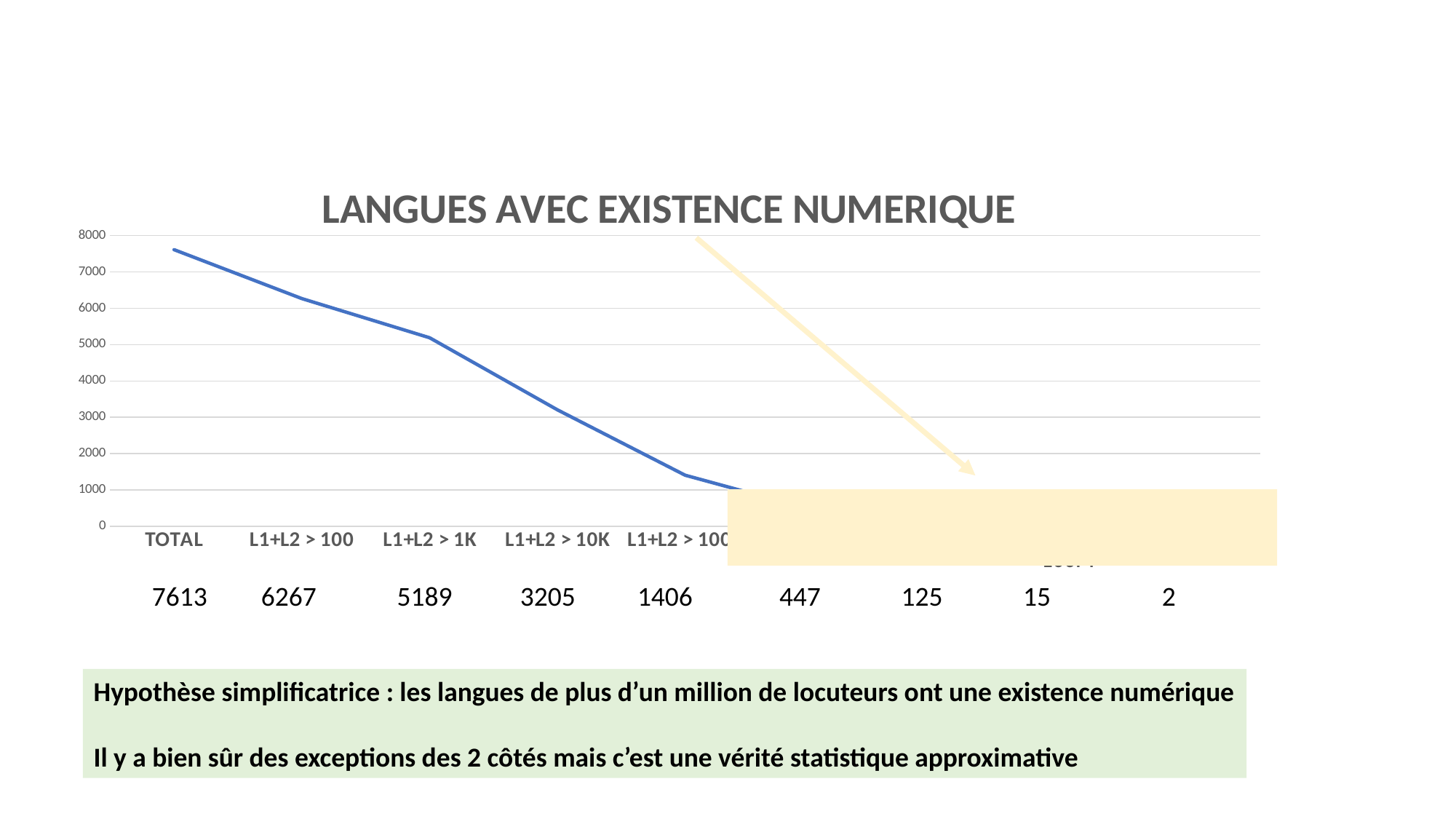
Which category has the highest value? TOTAL Which is larger, the value for L1+L2 > 1K or the value for L1+L2 > 10K? L1+L2 > 1K What is the title of the chart? LANGUES AVEC EXISTENCE NUMERIQUE What is the value for L1+L2 > 100? 6267 What is the value for L1+L2 > 1K? 5189 What is the difference between the values for L1+L2 > 1K and L1+L2 > 10K? 1984 What is the highest value shown on the vertical axis? 8000 What is the value for TOTAL? 7613 Do the values rise or fall from left to right along the x axis? fall What kind of chart is shown on the slide? line chart What is the difference between the values for TOTAL and L1+L2 > 100? 1346 What is the value for L1+L2 > 10K? 3205